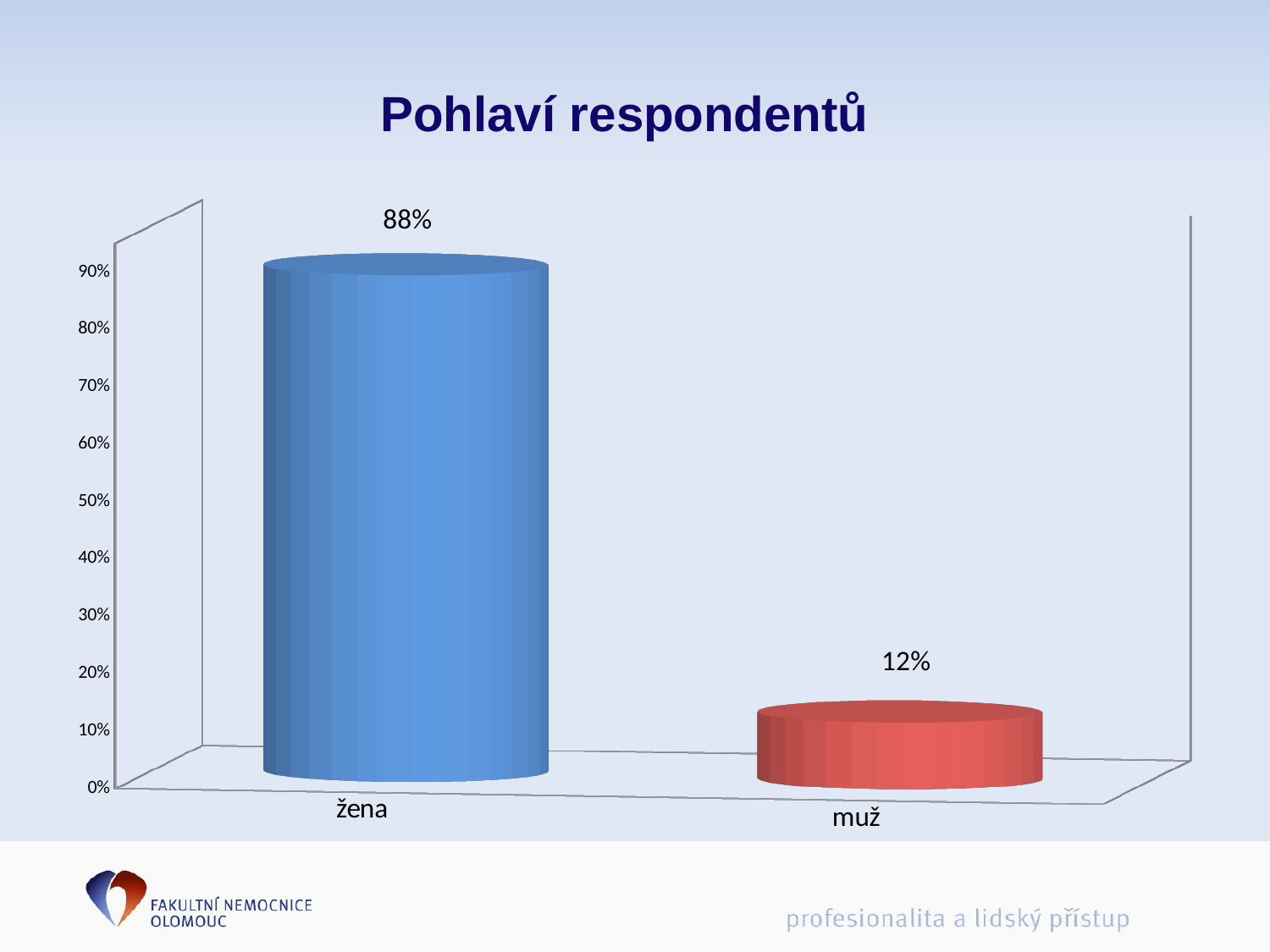
How many categories are shown on the chart? 2 Is the value for žena greater or less than 80%? greater What is the title of the chart? Pohlaví respondentů Which is larger, the value for žena or the value for muž? žena What kind of chart is shown on the slide? bar chart What is the value for žena? 88% Which category has the lowest value? muž What colour is the bar for muž? red Which category has the highest value? žena Is the value for muž greater or less than 20%? less What is the value for muž? 12% What is the difference between the values for žena and muž? 76%